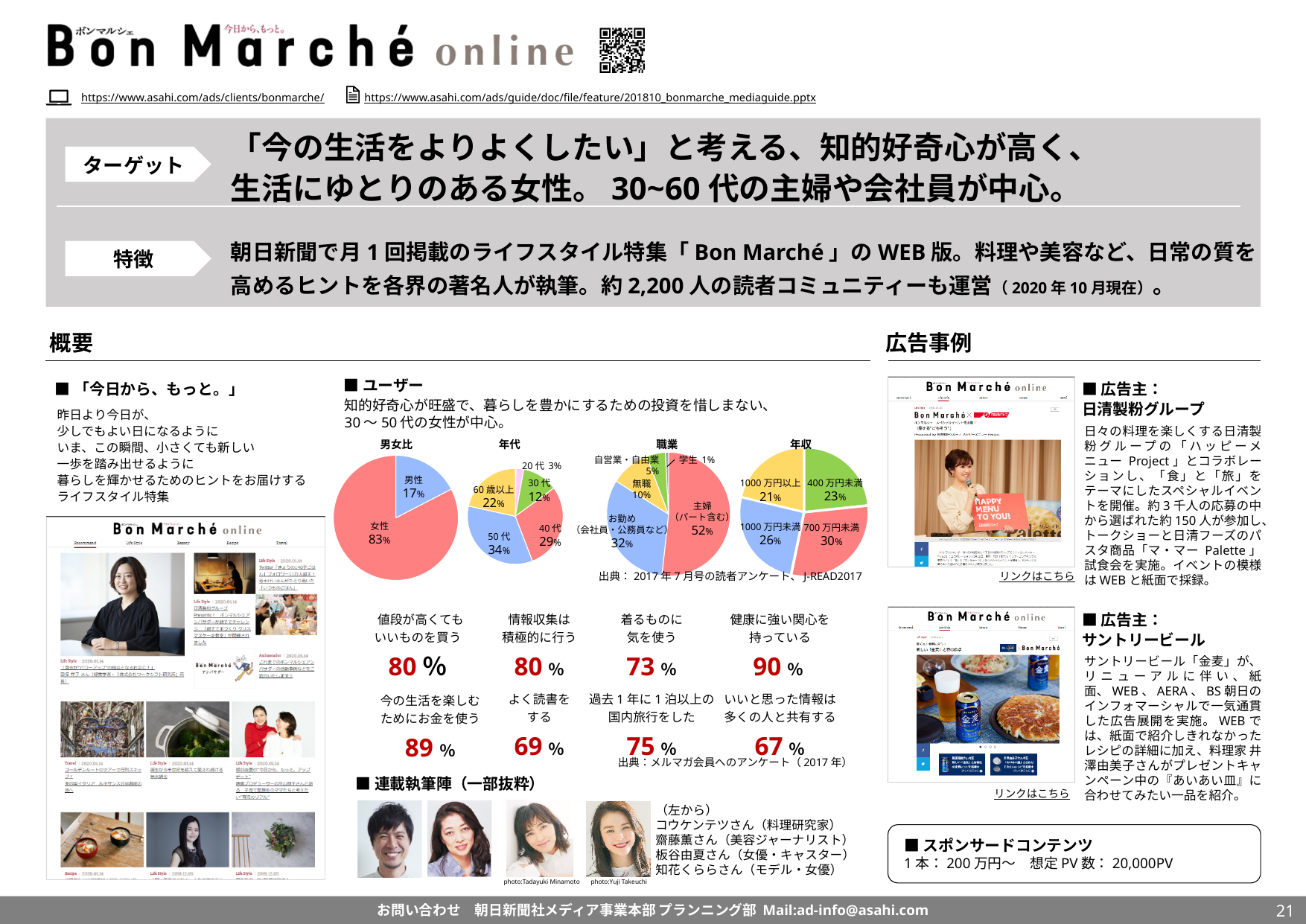
In the 職業 pie chart, which category has the smallest share? 学生 In the 職業 pie chart, what is the share for 主婦（パート含む）? 52% In the 男女比 pie chart, what share is 女性? 83% In the 年収 pie chart, which income bracket has the smallest share? 1000万円以上 In the 職業 pie chart, which is larger: お勤め（会社員・公務員など） or 無職? お勤め（会社員・公務員など） In the 男女比 pie chart, what share is 男性? 17% In the 年代 pie chart, which age group has the largest share? 50代 In the 年代 pie chart, what is the difference between the shares of 50代 and 30代? 22% How many pie charts are shown in the ユーザー section of the slide? 4 In the 年収 pie chart, what is the share for 700万円未満? 30% In the 年代 pie chart, what is the share for 40代? 29%